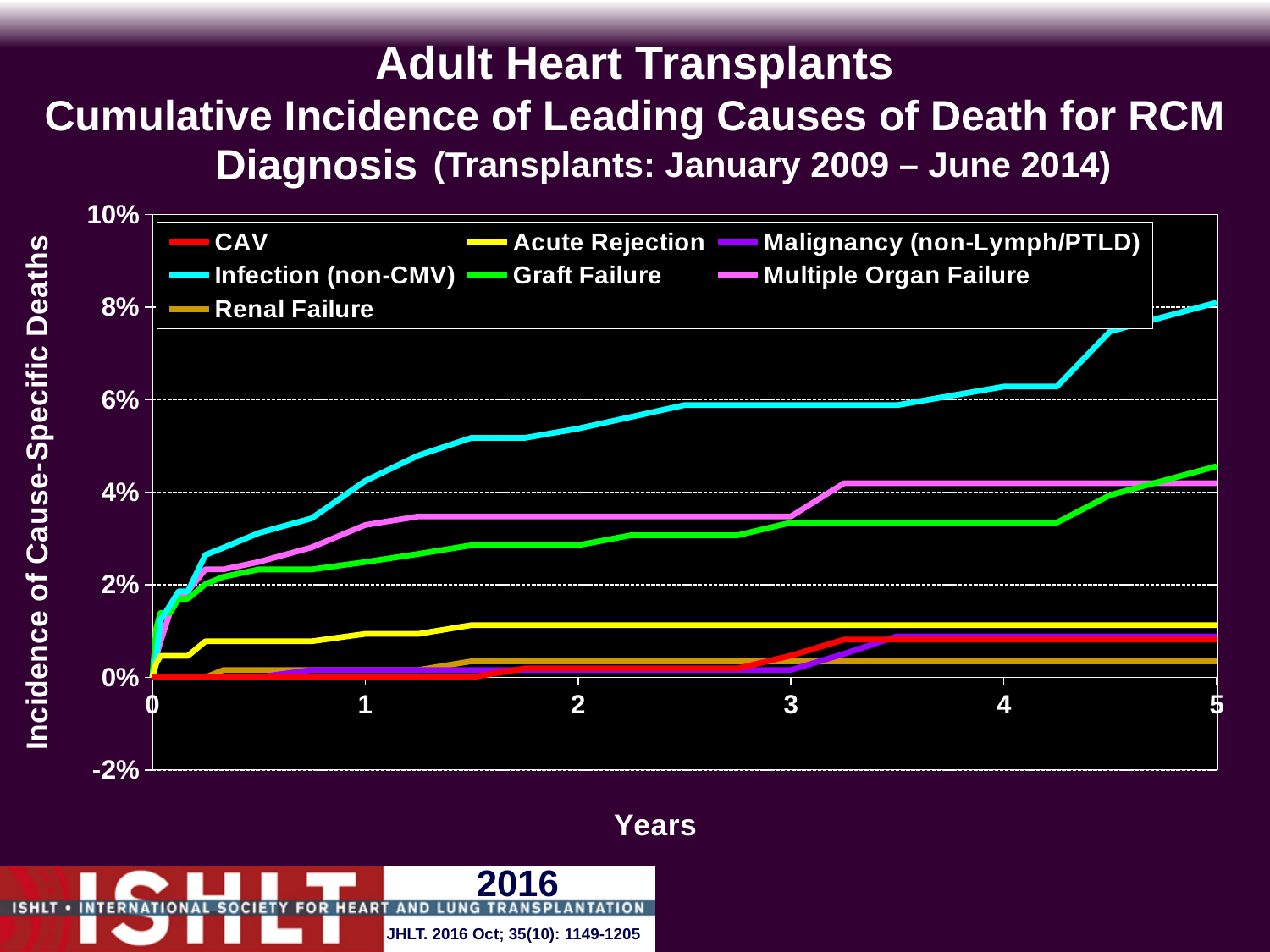
Which cause of death has the lowest cumulative incidence at 5 years? Renal Failure Is the value for Infection (non-CMV) at 2 years greater or less than 4%? greater At 2 years, which is larger: Multiple Organ Failure or Graft Failure? Multiple Organ Failure Does the Infection (non-CMV) line rise or fall from 0 to 5 years? rise At 5 years, which is larger: Infection (non-CMV) or Graft Failure? Infection (non-CMV) How many series does the legend list? 7 Is the value for Graft Failure at 5 years greater or less than 4%? greater Is the value for Multiple Organ Failure at 2 years greater or less than 4%? less Which cause of death has the highest cumulative incidence at 5 years? Infection (non-CMV) What is the label of the y axis? Incidence of Cause-Specific Deaths What kind of chart is shown on the slide? line chart